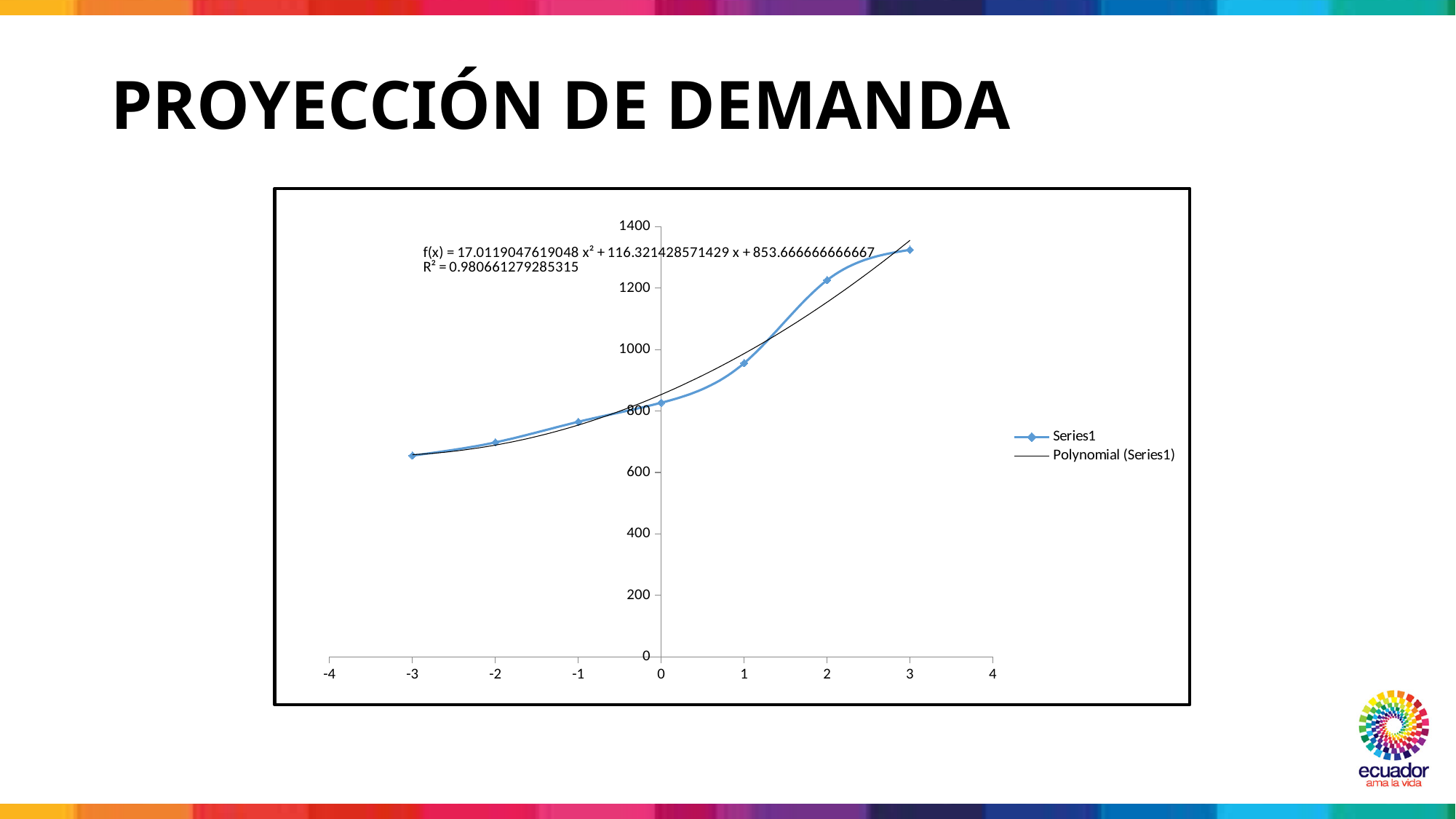
What are the two entries listed in the chart legend? Series1 and Polynomial (Series1) How many data points are plotted for Series1? 7 Is the Series1 value at x = 3 greater or less than 1200? greater Is the Series1 value at x = -3 greater or less than 800? less How many entries does the legend list? 2 What kind of chart is shown on the slide? line chart At which x value does Series1 have its lowest point? -3 What R² value is printed on the chart for the polynomial trendline? 0.980661279285315 Which is larger, the Series1 value at x = 2 or at x = -2? x = 2 Is the Series1 value at x = 2 greater or less than 1000? greater Do the Series1 values rise or fall as x increases from -3 to 3? rise At which x value does Series1 reach its highest point? 3